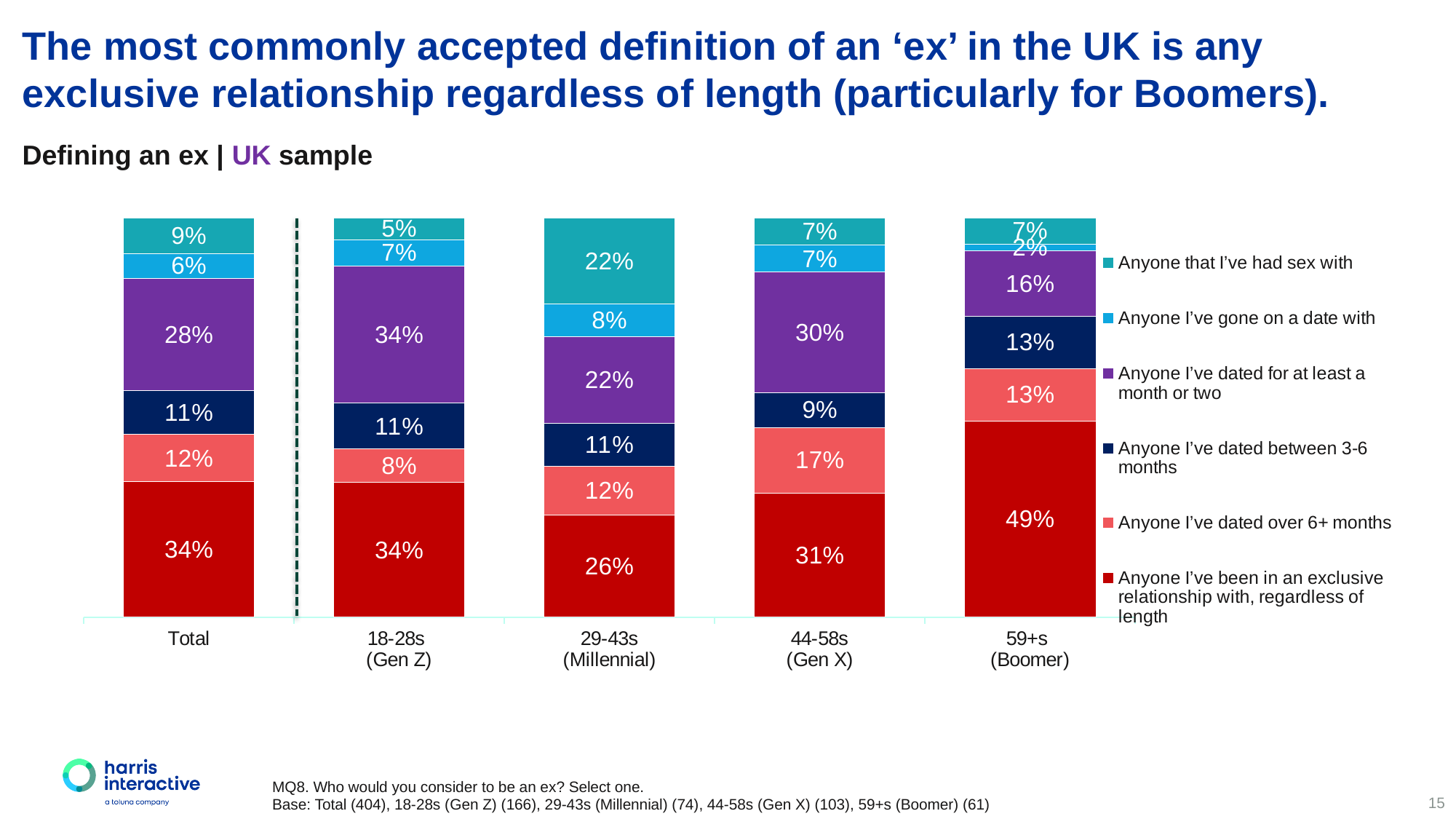
How many groups are shown along the x axis of the chart? 5 How many series does the legend list? 6 What percentage of the 29-43s (Millennial) group chose 'Anyone that I've had sex with'? 22% Which age group has the lowest share for 'Anyone I've been in an exclusive relationship with, regardless of length'? 29-43s (Millennial) Which group has a larger share for 'Anyone I've dated for at least a month or two': 18-28s (Gen Z) or 44-58s (Gen X)? 18-28s (Gen Z) Which age group has the highest share for 'Anyone I've been in an exclusive relationship with, regardless of length'? 59+s (Boomer) What is the subtitle of the chart on the slide? Defining an ex | UK sample What is the value for 'Anyone I've gone on a date with' in the Total group? 6% What kind of chart is shown on the slide? Stacked bar chart What percentage of the 44-58s (Gen X) group chose 'Anyone I've dated between 3-6 months'? 9% How many percentage points higher is 'Anyone I've dated over 6+ months' for 44-58s (Gen X) than for the Total group? 5 percentage points What percentage of the 59+s (Boomer) group define an ex as anyone they've been in an exclusive relationship with, regardless of length? 49%